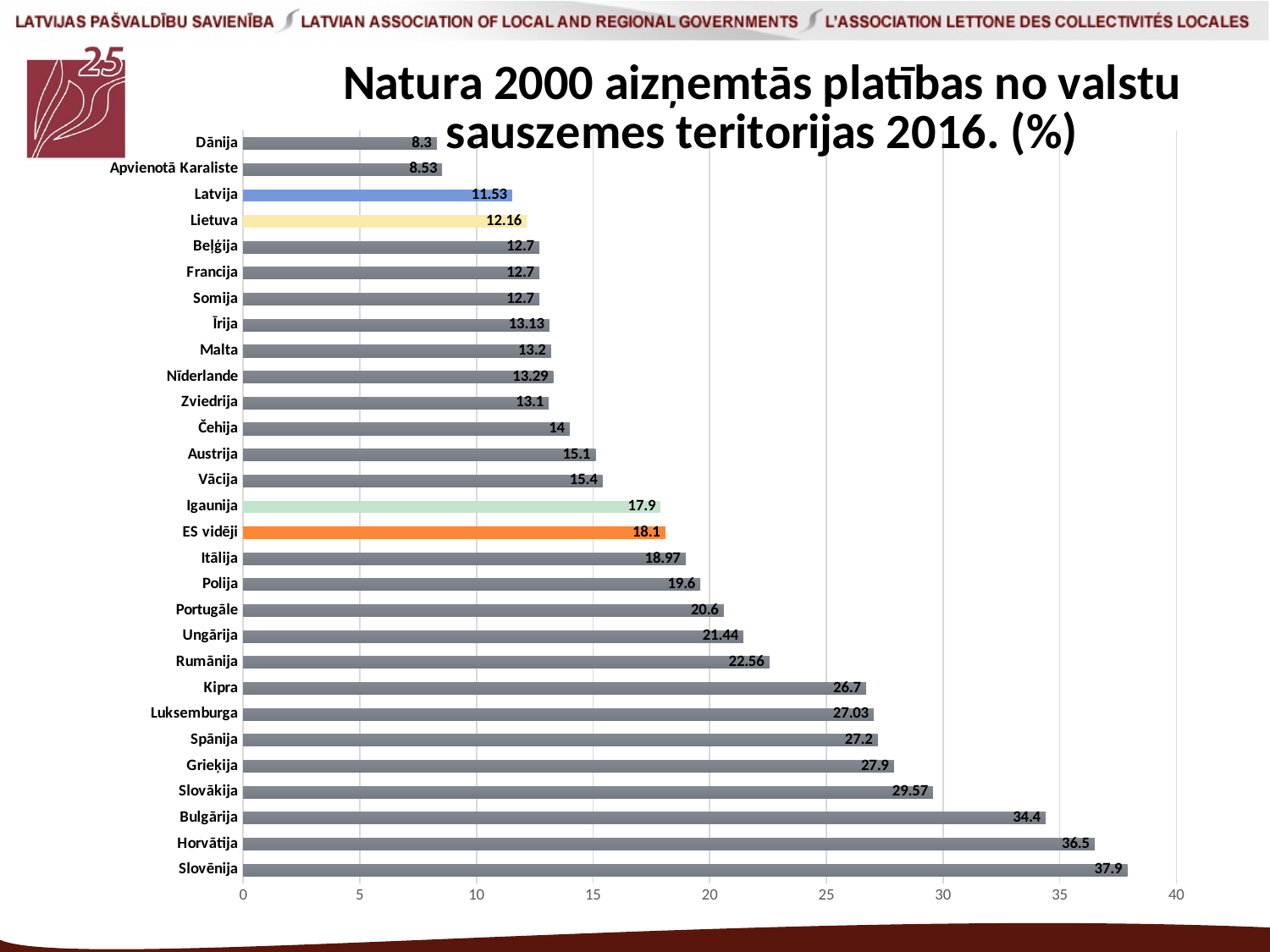
Which is larger, the value for Lietuva or the value for Latvija? Lietuva What is the title of the chart? Natura 2000 aizņemtās platības no valstu sauszemes teritorijas 2016. (%) What is the value for Latvija? 11.53 How many bars are shown in the chart? 29 What is the value for Igaunija? 17.9 What is the difference between the values for ES vidēji and Latvija? 6.57 Which country has the lowest value? Dānija What is the value for ES vidēji? 18.1 What is the difference between the values for Slovēnija and Dānija? 29.6 What is the value for Slovākija? 29.57 What kind of chart is shown on the slide? Bar chart Which country has the highest value? Slovēnija